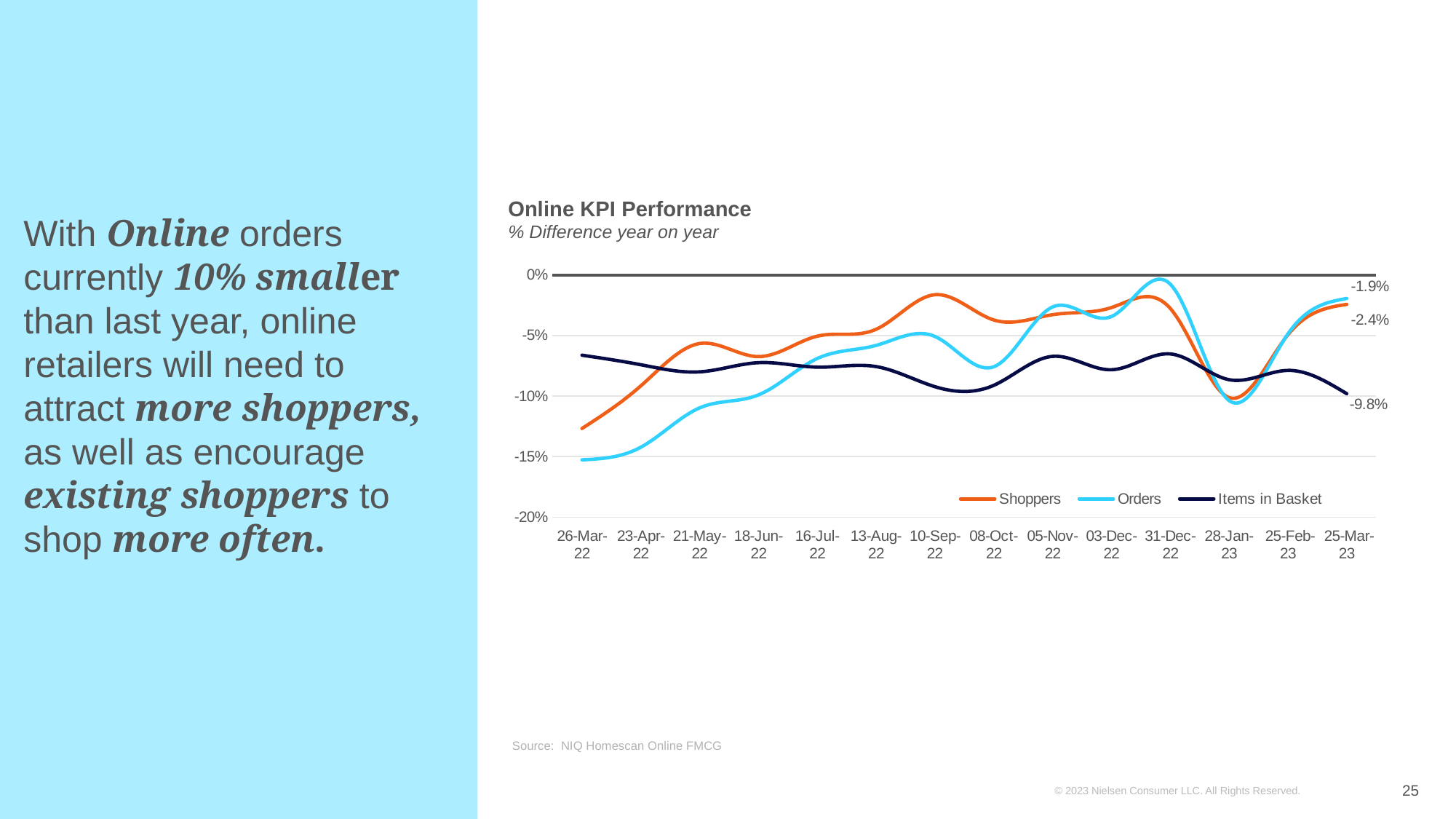
What is the subtitle shown under the title 'Online KPI Performance'? % Difference year on year What is the value for Shoppers at 25-Mar-23 in the Online KPI Performance chart? -2.4% At 26-Mar-22, which is higher in the Online KPI Performance chart: Shoppers or Orders? Shoppers Does the Orders line rise or fall overall from 26-Mar-22 to 25-Mar-23? rise How many dates are shown on the x axis of the Online KPI Performance chart? 14 What kind of chart is shown under the title 'Online KPI Performance'? Line chart Is the value for Orders at 26-Mar-22 greater or less than -10%? less Which series has the highest value at 25-Mar-23 in the Online KPI Performance chart? Orders What is the value for Items in Basket at 25-Mar-23 in the Online KPI Performance chart? -9.8% What is the value for Orders at 25-Mar-23 in the Online KPI Performance chart? -1.9% Which series has the lowest value at 25-Mar-23 in the Online KPI Performance chart? Items in Basket How many series does the legend of the Online KPI Performance chart list? 3